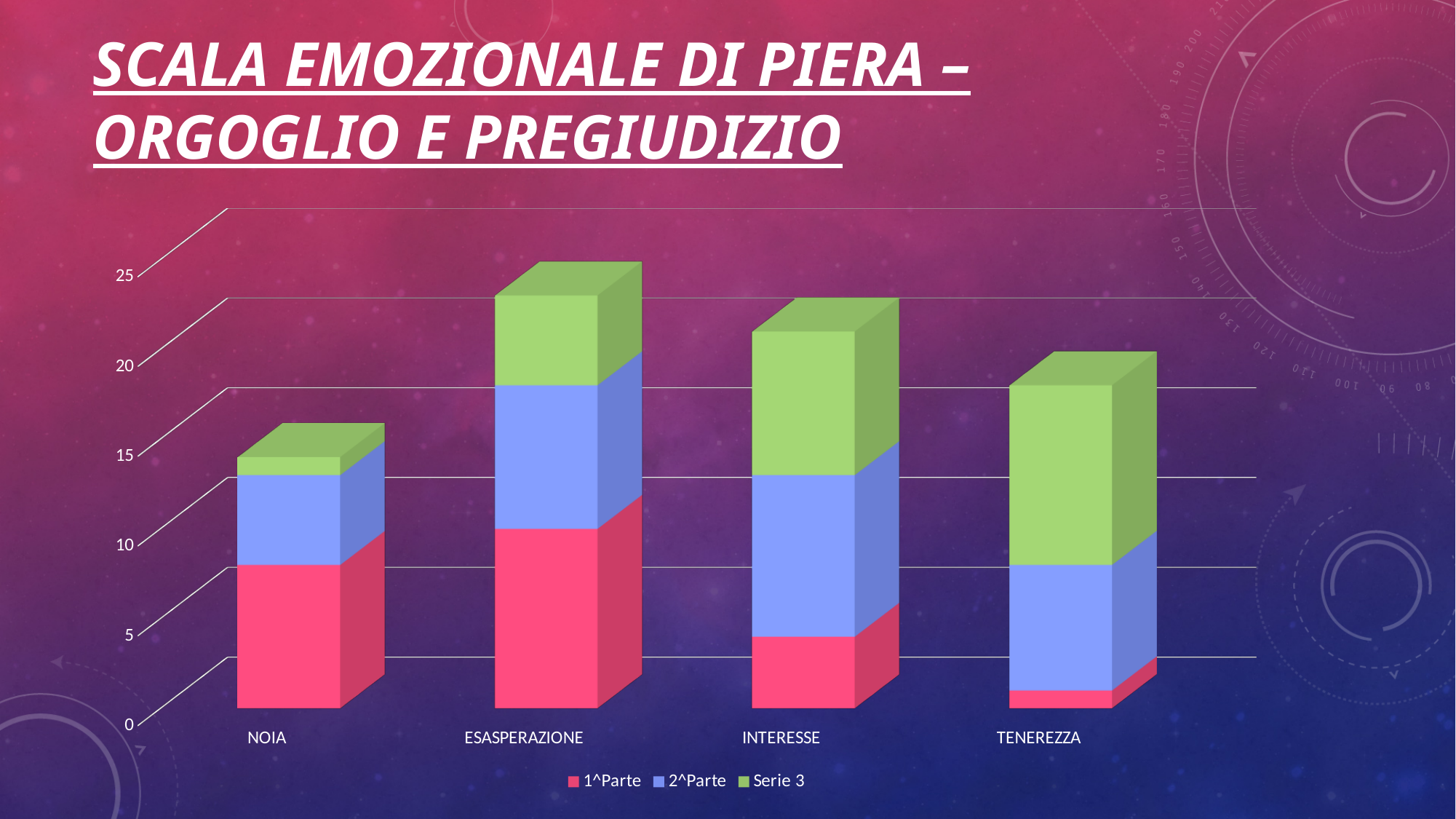
What kind of chart is shown on the slide? Stacked bar chart Which is larger, the 1^Parte value for NOIA or the 1^Parte value for INTERESSE? NOIA How many series does the chart legend list? 3 Is the total stacked value for ESASPERAZIONE greater or less than 20? greater How many categories are shown on the x axis of the chart? 4 Which category has the tallest stacked bar overall? ESASPERAZIONE What are the three series names listed in the chart legend? 1^Parte, 2^Parte, Serie 3 Which category has the largest Serie 3 segment? TENEREZZA Which category has the shortest stacked bar overall? NOIA Which category has the smallest 1^Parte segment? TENEREZZA Is the 1^Parte value for TENEREZZA greater or less than 5? less Is the total stacked value for NOIA greater or less than 10? greater